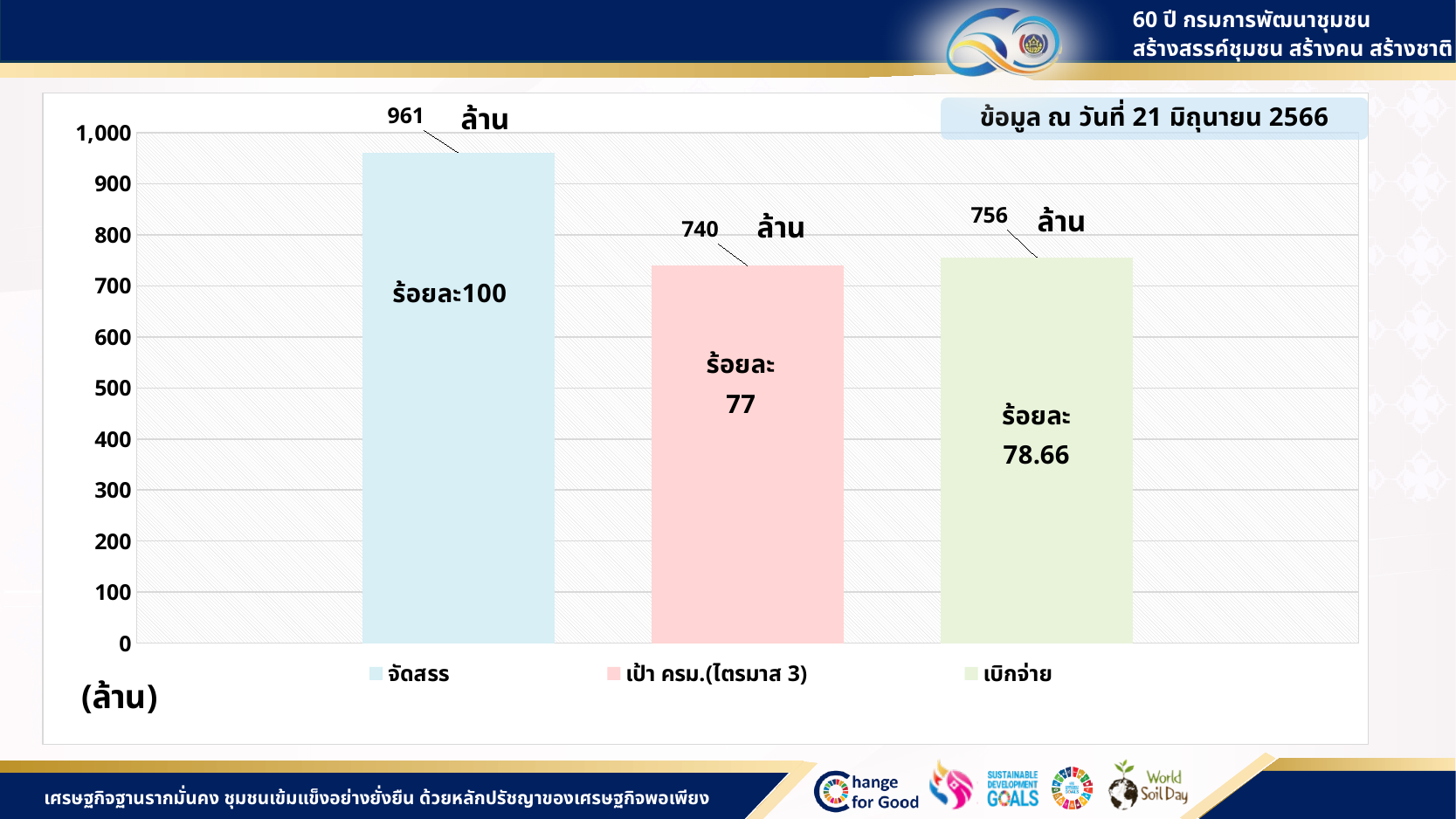
Which category has the lowest value? เป้า ครม.(ไตรมาส 3) Is the value for จัดสรร greater or less than 900? greater What kind of chart is shown on the slide? bar chart What is the value for เบิกจ่าย? 756 What is the difference between the values for จัดสรร and เบิกจ่าย? 205 What is the value for เป้า ครม.(ไตรมาส 3)? 740 What percentage (ร้อยละ) is shown inside the เป้า ครม.(ไตรมาส 3) bar? 77 Which category has the highest value? จัดสรร What is the difference between the values for เบิกจ่าย and เป้า ครม.(ไตรมาส 3)? 16 How many bars are shown in the chart? 3 What percentage (ร้อยละ) is shown inside the เบิกจ่าย bar? 78.66 What is the value for จัดสรร? 961